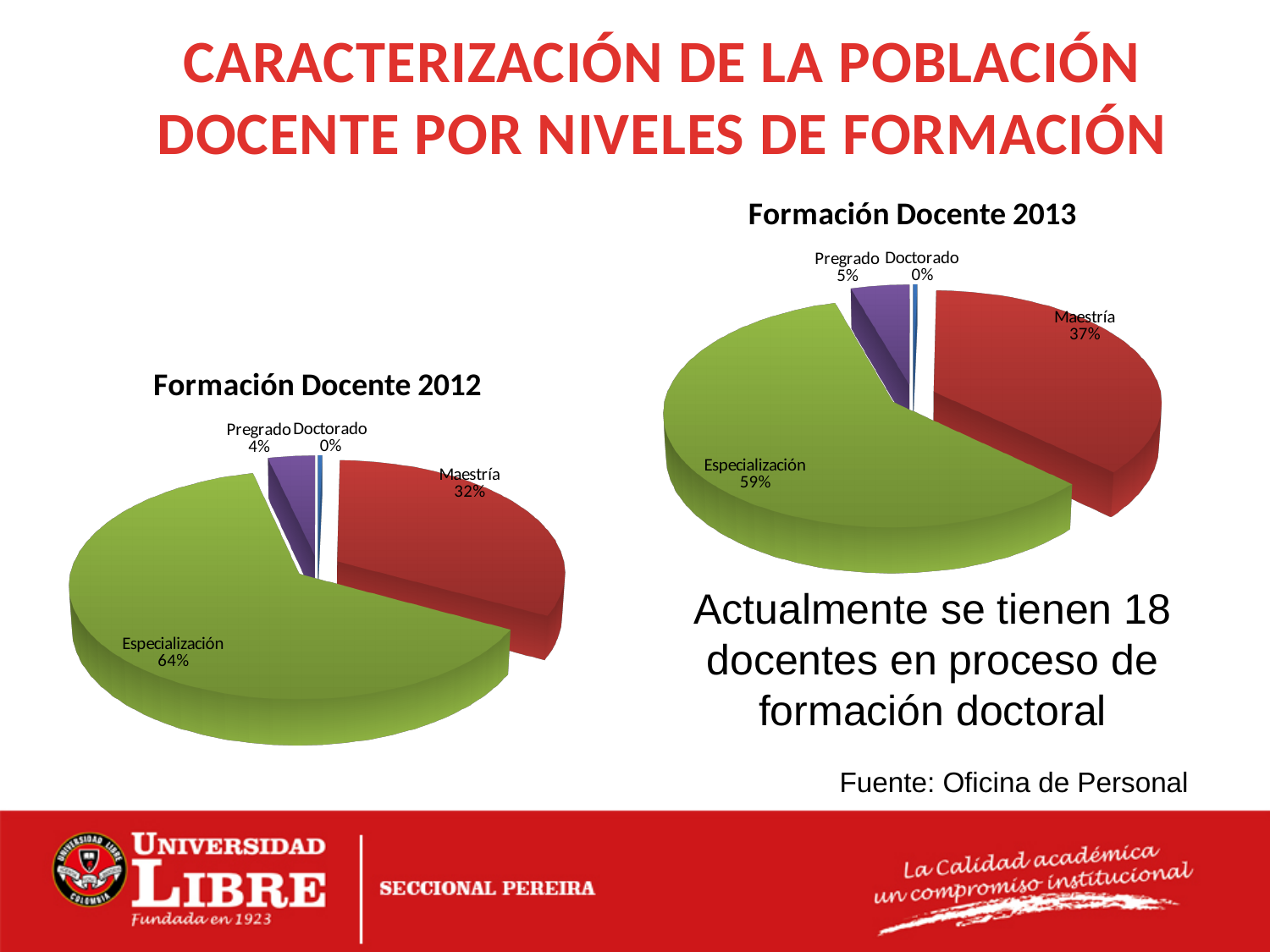
In the 'Formación Docente 2013' chart, what share does Maestría have? 37% In the 'Formación Docente 2012' chart, which category has the largest slice? Especialización In the 'Formación Docente 2013' chart, what is the difference between the Especialización and Maestría shares? 22 percentage points In the 'Formación Docente 2012' chart, what share does Especialización have? 64% What type of chart is 'Formación Docente 2013'? Pie chart In the 'Formación Docente 2013' chart, what share does Pregrado have? 5% What is the title of the chart on the left side of the slide? Formación Docente 2012 In the 'Formación Docente 2012' chart, what colour is the Especialización slice? Green In the 'Formación Docente 2012' chart, what share does Doctorado have? 0% In the 'Formación Docente 2013' chart, which category has the smallest slice? Doctorado How many categories does the 'Formación Docente 2012' chart show? 4 Is the Maestría share larger in the 'Formación Docente 2012' chart or the 'Formación Docente 2013' chart? Formación Docente 2013